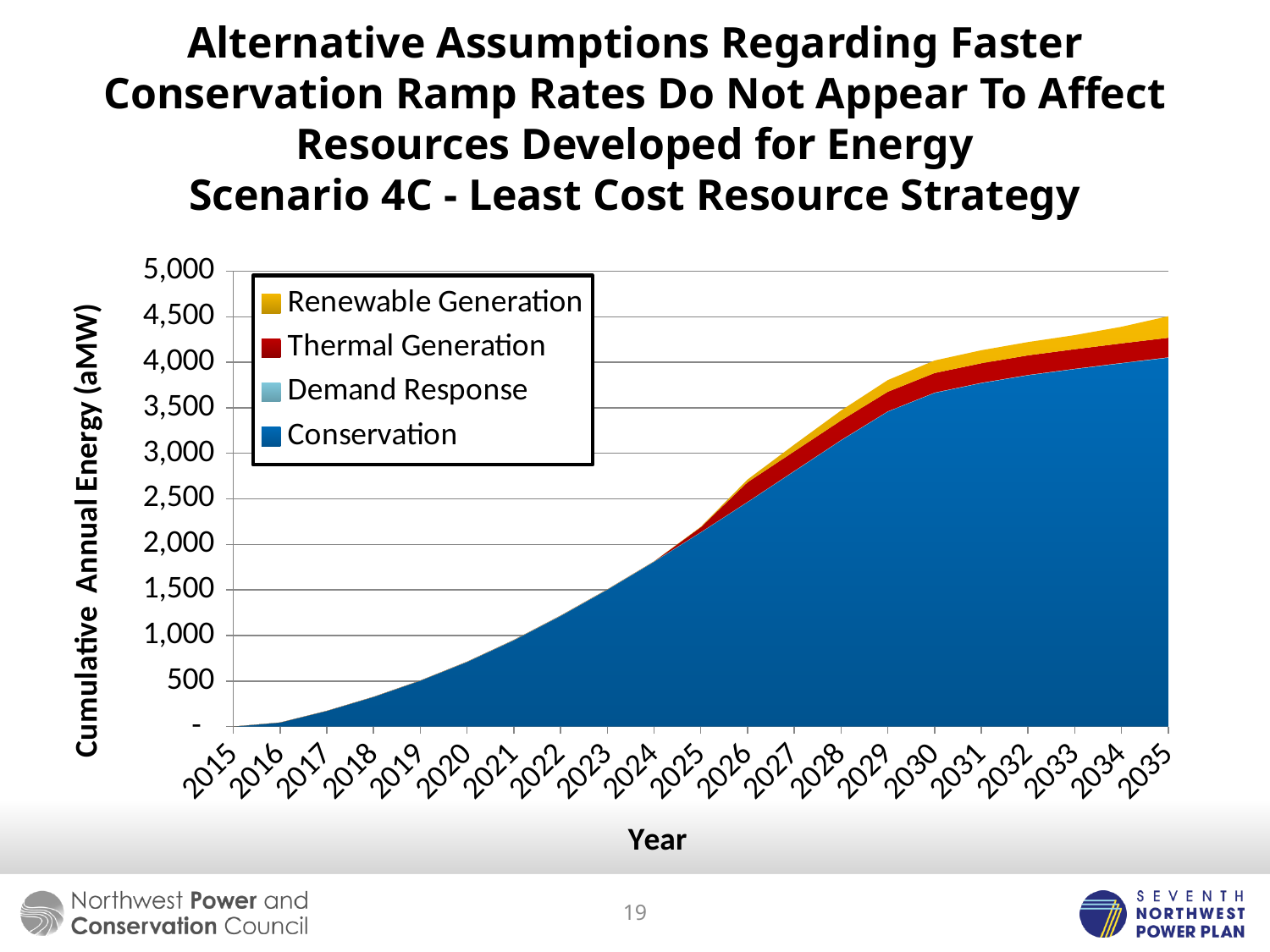
Which series accounts for the largest share of the stacked area in 2035? Conservation What is the label of the x axis? Year Is the total stacked value in 2028 greater or less than 3,000? greater How many years are shown along the x axis? 21 How many series does the legend list? 4 Is the Conservation value in 2020 greater or less than 500? greater Which series is shown in yellow in the legend? Renewable Generation What kind of chart is shown on the slide? Stacked area chart Is the Conservation value in 2018 greater or less than 500? less Does the cumulative annual energy rise or fall from 2015 to 2035? Rises